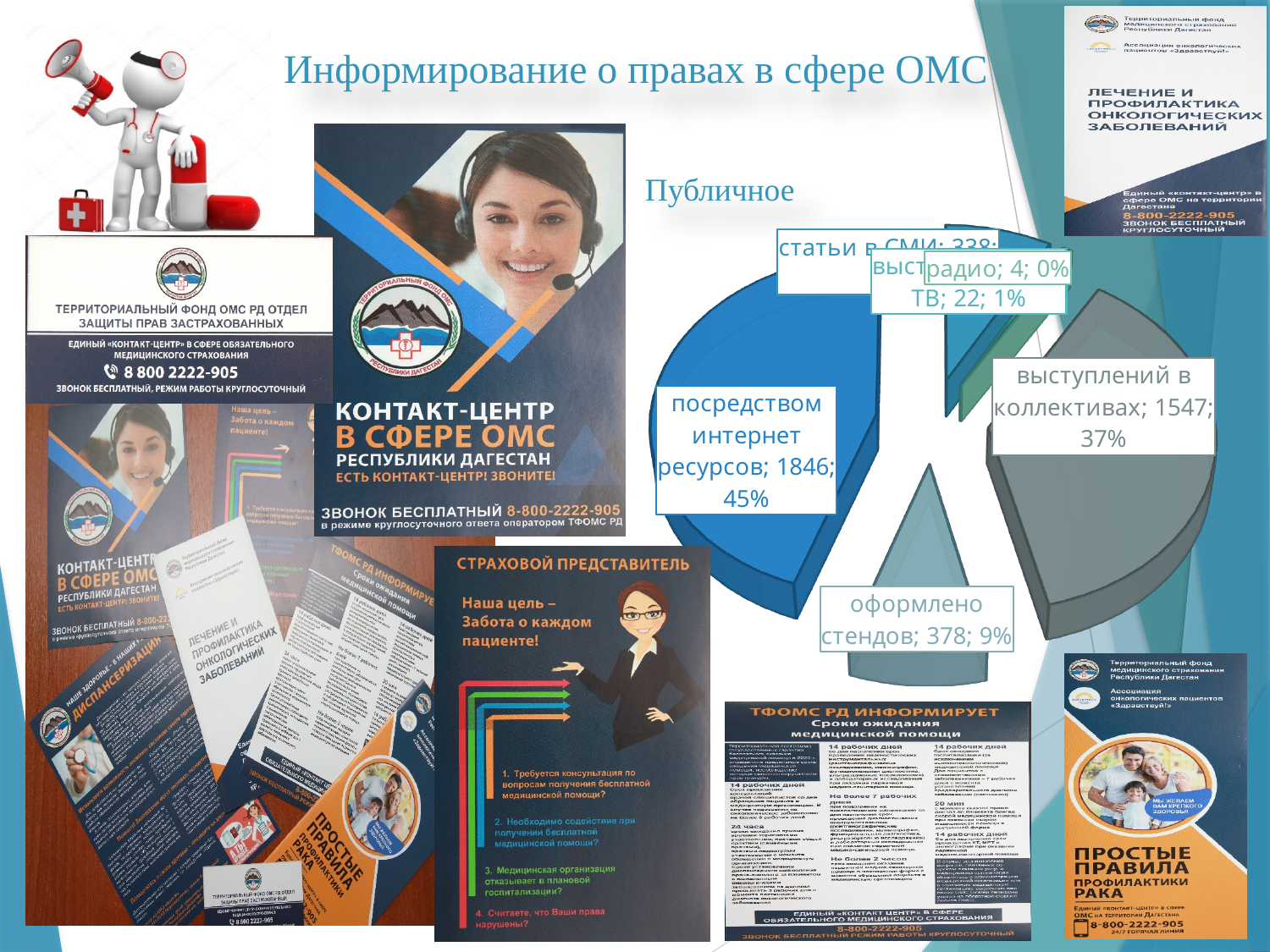
What type of chart is shown on the slide? pie chart What is the value for 'статьи в СМИ'? 338 What is the value for 'радио'? 4 Which category has the largest share of the pie? посредством интернет ресурсов What is the difference between the values for 'посредством интернет ресурсов' and 'выступлений в коллективах'? 299 How many items were reported for 'посредством интернет ресурсов'? 1846 Which is larger: the value for 'ТВ' or the value for 'радио'? ТВ What share of the pie does 'оформлено стендов' represent? 9% What is the value for 'оформлено стендов'? 378 What is the value for 'выступлений в коллективах'? 1547 What is the value for 'ТВ'? 22 What share of the pie does 'выступлений в коллективах' represent? 37%